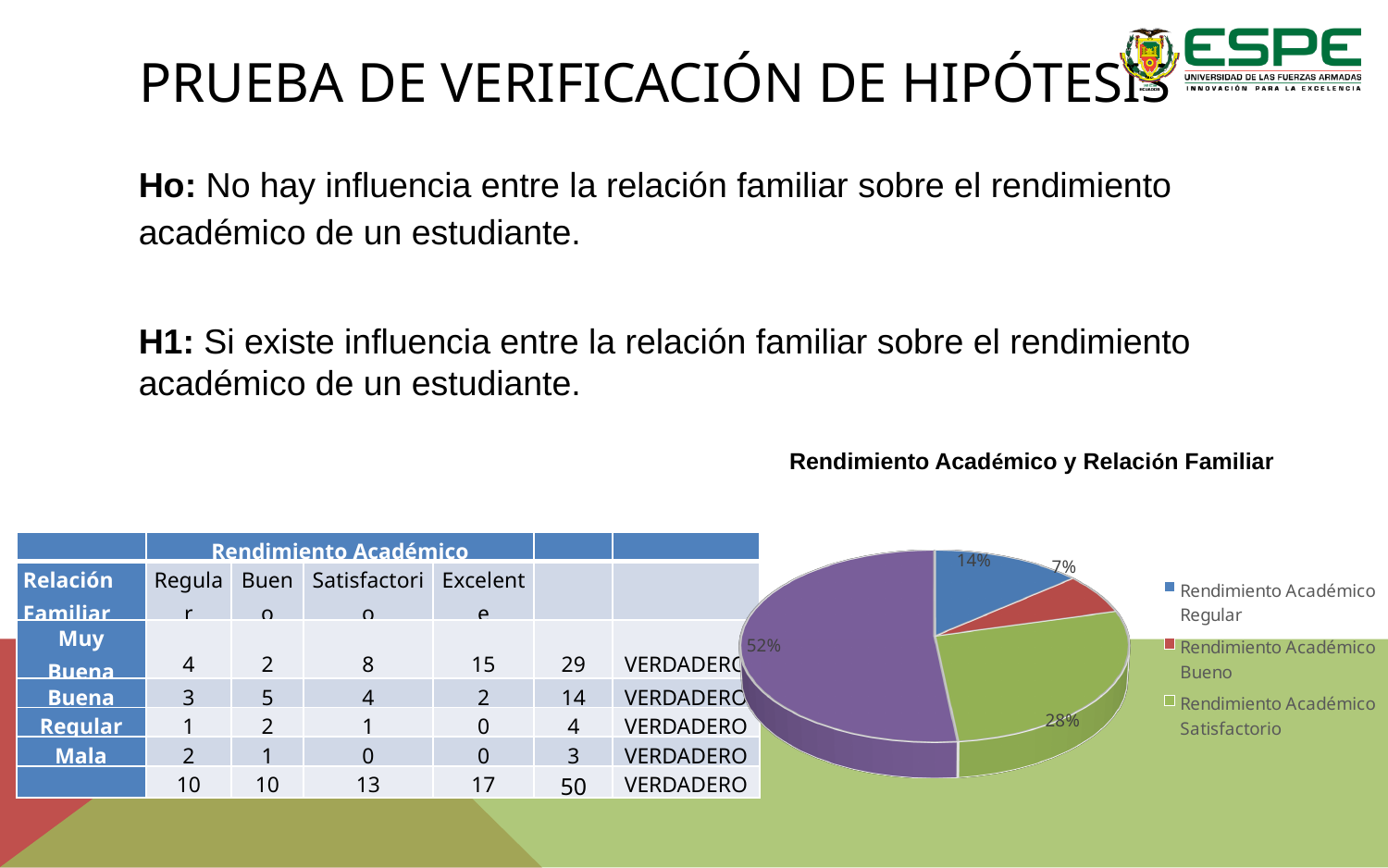
By how many percentage points does the Rendimiento Académico Satisfactorio slice exceed the Rendimiento Académico Regular slice? 14 percentage points Which slice is larger in the pie chart: Rendimiento Académico Satisfactorio or Rendimiento Académico Regular? Rendimiento Académico Satisfactorio What percentage is printed on the largest slice of the pie chart? 52% Which of the legend categories has the smallest slice in the pie chart? Rendimiento Académico Bueno What is the title of the chart on the slide? Rendimiento Académico y Relación Familiar What percentage does the pie chart show for Rendimiento Académico Bueno? 7% What percentage does the pie chart show for Rendimiento Académico Satisfactorio? 28% By how many percentage points does the Rendimiento Académico Regular slice exceed the Rendimiento Académico Bueno slice? 7 percentage points What kind of chart is shown on the slide? Pie chart What percentage does the pie chart show for Rendimiento Académico Regular? 14% How many slices does the pie chart have? 4 What colour is the Rendimiento Académico Regular slice in the pie chart? Blue